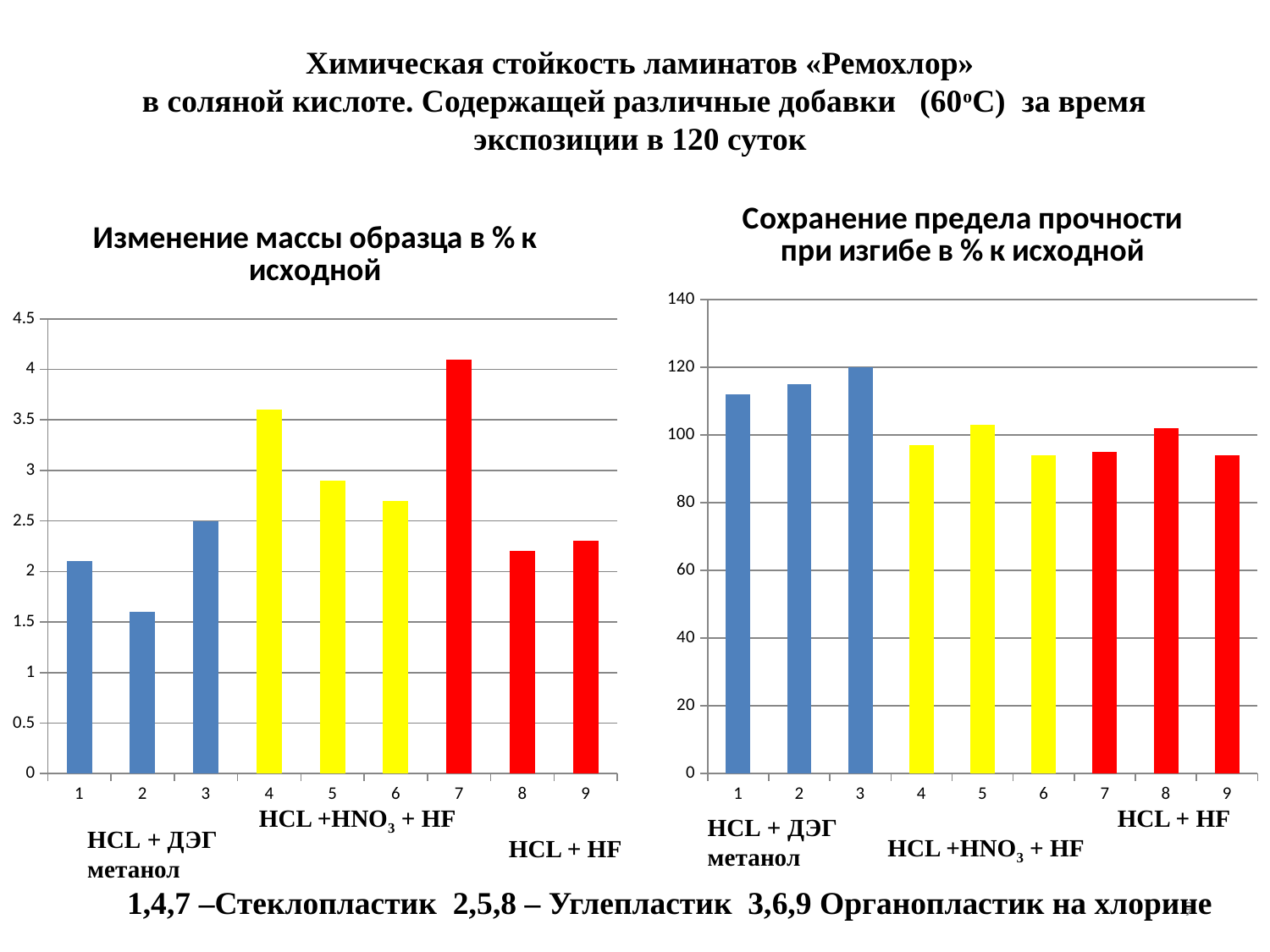
In the right chart, "Сохранение предела прочности при изгибе в % к исходной", which is larger, the value for category 1 or the value for category 4? category 1 In the left chart, "Изменение массы образца в % к исходной", which category has the lowest bar? 2 In the left chart, "Изменение массы образца в % к исходной", which category has the highest bar? 7 In the right chart, "Сохранение предела прочности при изгибе в % к исходной", is the value for category 4 greater or less than 100? less In the left chart, "Изменение массы образца в % к исходной", which is larger, the value for category 4 or the value for category 5? category 4 In the left chart, "Изменение массы образца в % к исходной", is the value for category 2 greater or less than 2? less What kind of chart is the left chart, "Изменение массы образца в % к исходной"? bar chart In the left chart, "Изменение массы образца в % к исходной", is the value for category 7 greater or less than 4? greater How many bars (categories) are plotted in the right chart, "Сохранение предела прочности при изгибе в % к исходной"? 9 In the right chart, "Сохранение предела прочности при изгибе в % к исходной", what is the value for category 3? 120 In the left chart, what colour are the bars for categories 4, 5 and 6? yellow In the right chart, "Сохранение предела прочности при изгибе в % к исходной", which category has the highest bar? 3